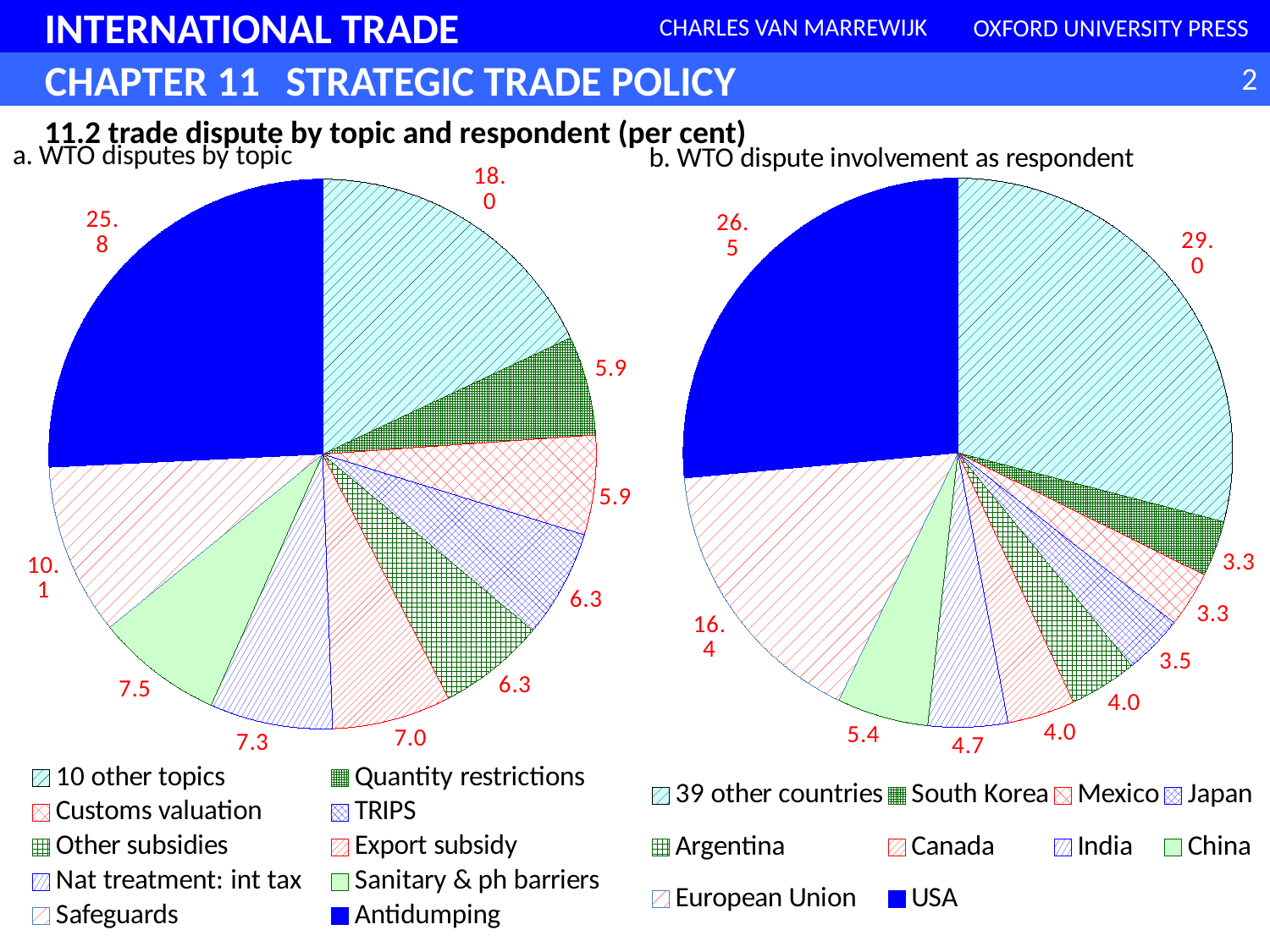
On the right chart (b. WTO dispute involvement as respondent), what percentage is shown for China? 5.4 How many slices does the right chart (b. WTO dispute involvement as respondent) have? 10 On the left chart (a. WTO disputes by topic), what is the difference between the Antidumping share and the 10 other topics share? 7.8 On the right chart (b. WTO dispute involvement as respondent), what percentage is shown for USA? 26.5 On the right chart (b. WTO dispute involvement as respondent), what is the difference between the USA share and the European Union share? 10.1 On the right chart (b. WTO dispute involvement as respondent), which category has the largest share? 39 other countries On the right chart (b. WTO dispute involvement as respondent), what percentage is shown for European Union? 16.4 On the left chart (a. WTO disputes by topic), what percentage is shown for 10 other topics? 18.0 On the left chart (a. WTO disputes by topic), what percentage is shown for Antidumping? 25.8 On the left chart (a. WTO disputes by topic), which is larger, Antidumping or Safeguards? Antidumping What type of chart is used for a. WTO disputes by topic? Pie chart On the left chart (a. WTO disputes by topic), which topic has the largest share? Antidumping